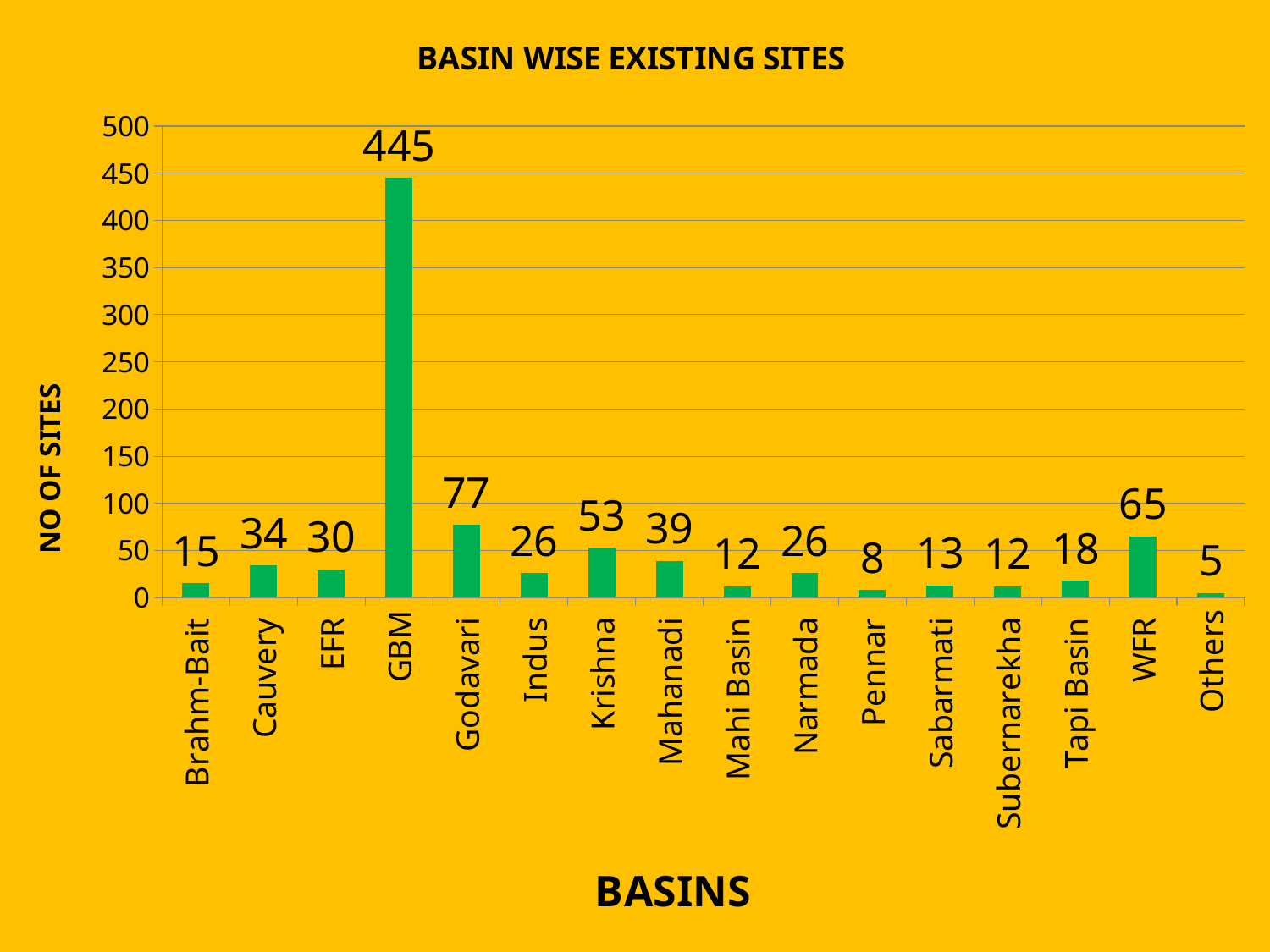
How many basin categories are shown on the x axis? 16 Which has more existing sites, Krishna or Mahanadi? Krishna What is the number of existing sites for GBM? 445 Which category has the lowest number of existing sites? Others Which basin has the highest number of existing sites? GBM What type of chart is shown on the slide? Bar chart What is the title of the chart? BASIN WISE EXISTING SITES What is the number of existing sites for Godavari? 77 What is the difference in number of sites between GBM and Godavari? 368 What is the label of the y axis? NO OF SITES What is the difference in number of sites between Godavari and WFR? 12 What is the number of existing sites for Pennar? 8